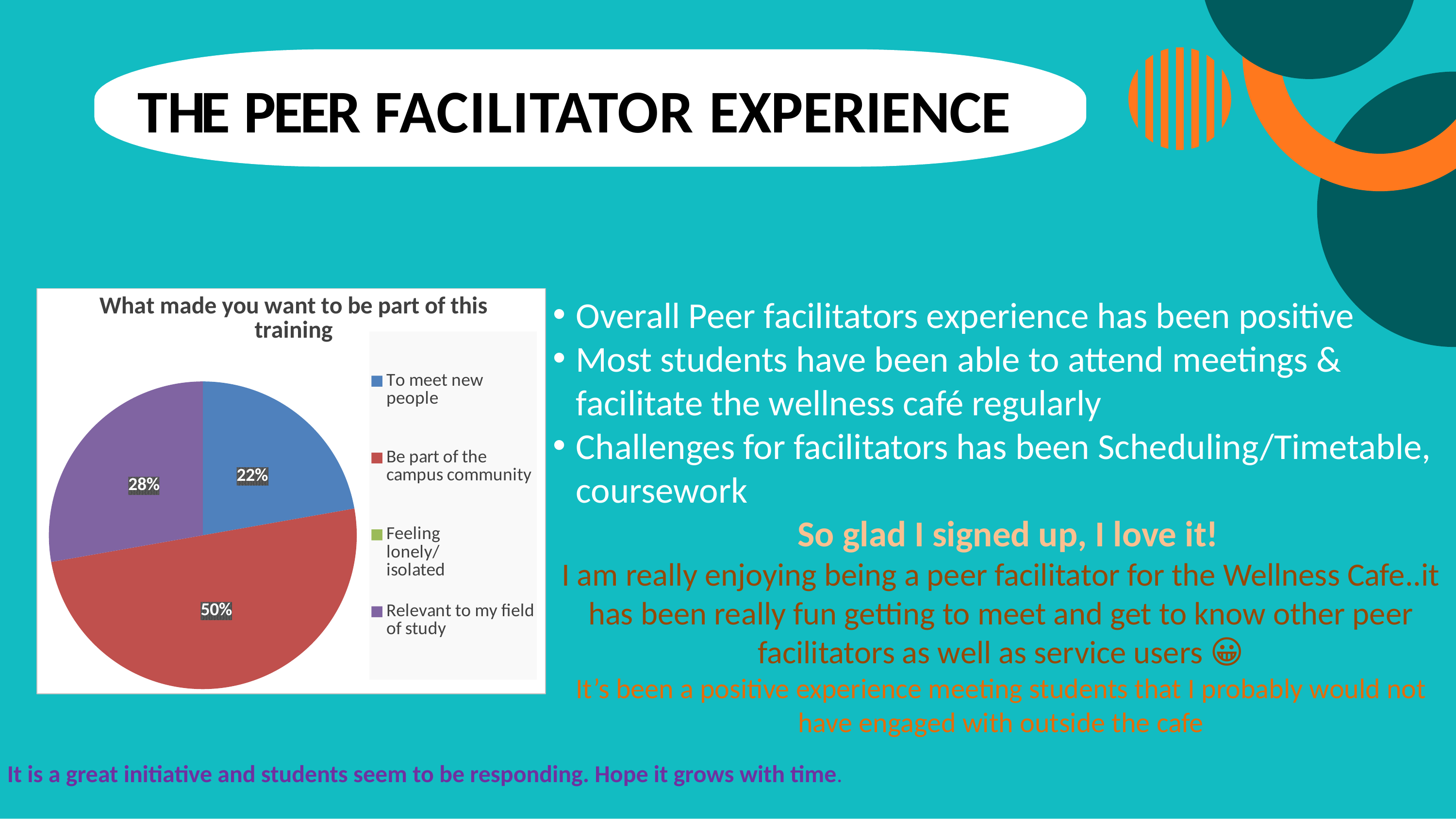
Which of the labelled slices is the smallest? To meet new people How many categories does the chart's legend list? 4 What colour is the slice for "Be part of the campus community"? red Which is larger: the slice for "Relevant to my field of study" or the slice for "To meet new people"? Relevant to my field of study Which category has the largest slice of the pie? Be part of the campus community What share of the pie is labelled for "To meet new people"? 22% What share of the pie is labelled for "Be part of the campus community"? 50% What is the title of the chart? What made you want to be part of this training What share of the pie is labelled for "Relevant to my field of study"? 28% What is the difference in percentage points between "Be part of the campus community" and "Relevant to my field of study"? 22 What is the difference in percentage points between "Relevant to my field of study" and "To meet new people"? 6 What kind of chart is shown on the slide? pie chart